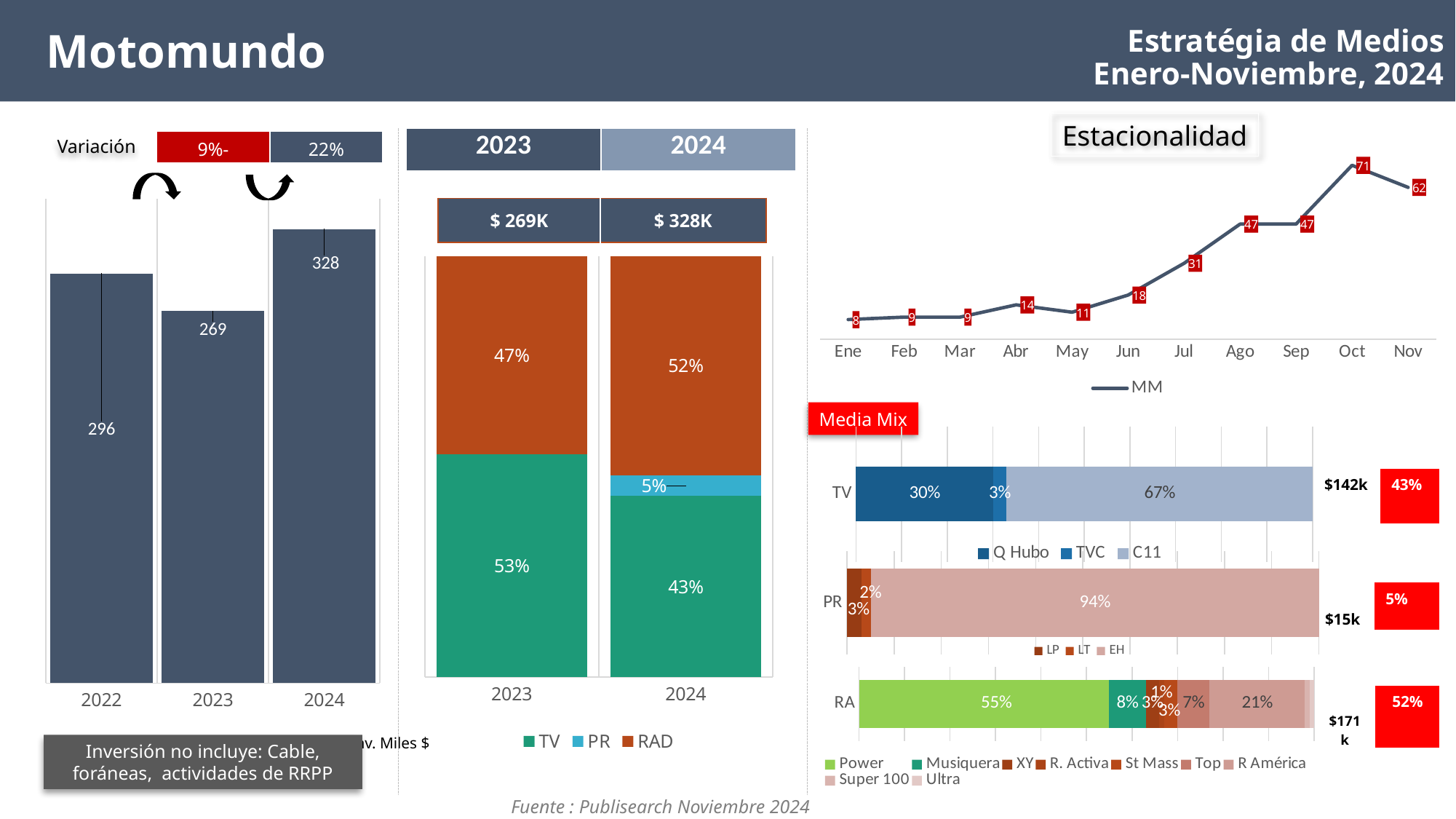
In the Media Mix chart, what share does Power have in the RA bar? 55% In the middle stacked bar chart (2023 vs 2024 media split), how many series does the legend list? 3 In the middle stacked bar chart (2023 vs 2024 media split), what share does TV have in 2023? 53% In the left bar chart of yearly investment, which year has the lowest value? 2023 In the Media Mix chart, what share does C11 have in the TV bar? 67% In the Estacionalidad line chart, which month has the lowest value? Ene In the left bar chart of yearly investment, which year has the highest value? 2024 In the left bar chart of yearly investment, what is the value for 2022? 296 In the left bar chart of yearly investment, what is the difference between the 2024 and 2023 values? 59 In the Estacionalidad line chart, what is the value for Oct? 71 In the Estacionalidad line chart, how many months are plotted? 11 In the middle stacked bar chart (2023 vs 2024 media split), what share does RAD have in 2024? 52%